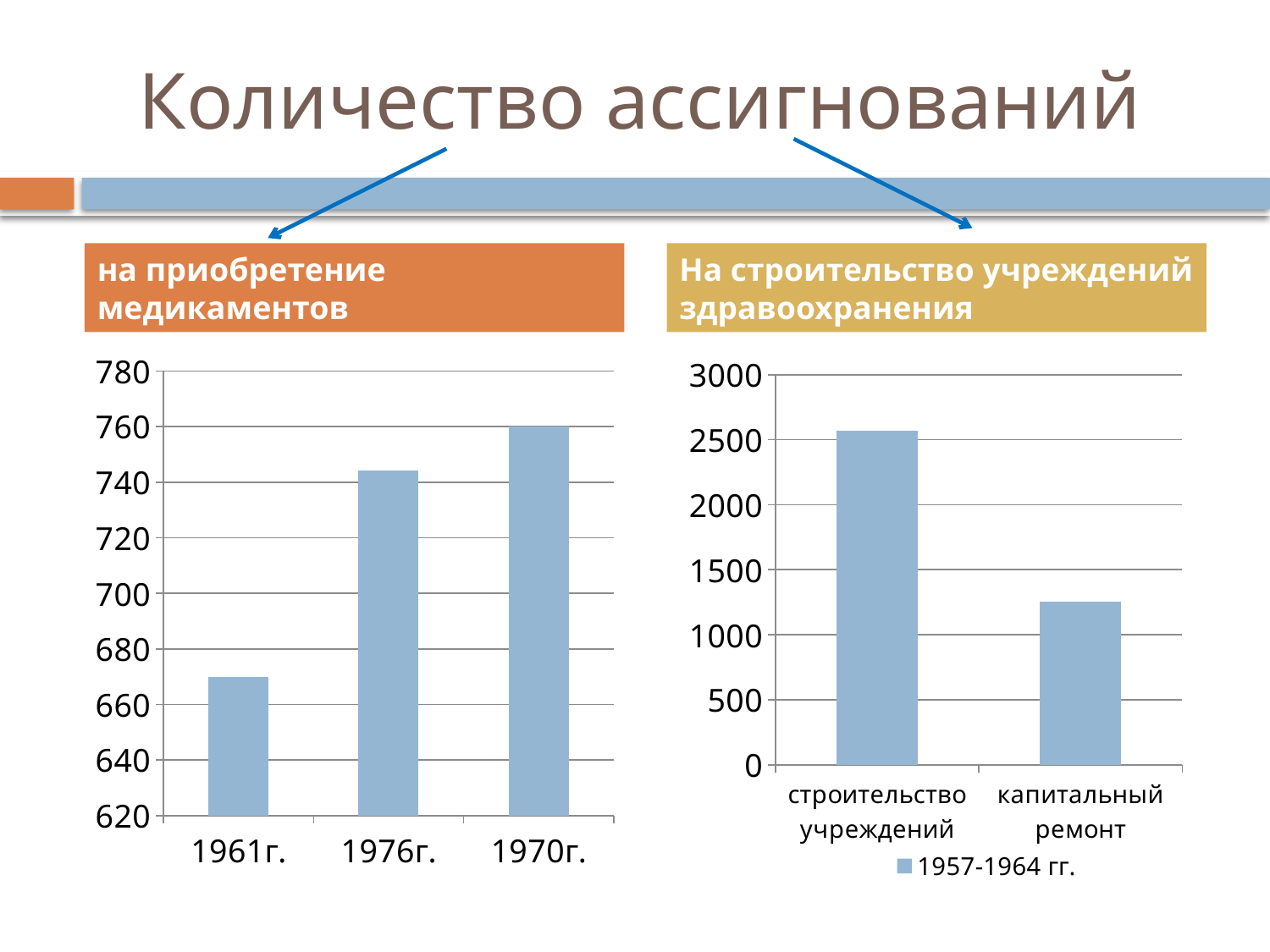
On the left chart (на приобретение медикаментов), which category has the lowest value? 1961г. On the right chart (На строительство учреждений здравоохранения), is the value for капитальный ремонт greater or less than 1500? less On the left chart (на приобретение медикаментов), which category has the highest value? 1970г. On the left chart (на приобретение медикаментов), is the value for 1961г. greater or less than 680? less On the left chart (на приобретение медикаментов), what is the value for 1970г.? 760 On the right chart (На строительство учреждений здравоохранения), is the value for строительство учреждений greater or less than 2500? greater On the left chart (на приобретение медикаментов), do the bars rise or fall from left to right? rise On the right chart (На строительство учреждений здравоохранения), which category has the higher value? строительство учреждений On the right chart (На строительство учреждений здравоохранения), what series does the legend list? 1957-1964 гг. What type of chart is the right chart (На строительство учреждений здравоохранения)? bar chart On the left chart (на приобретение медикаментов), how many categories are shown on the x axis? 3